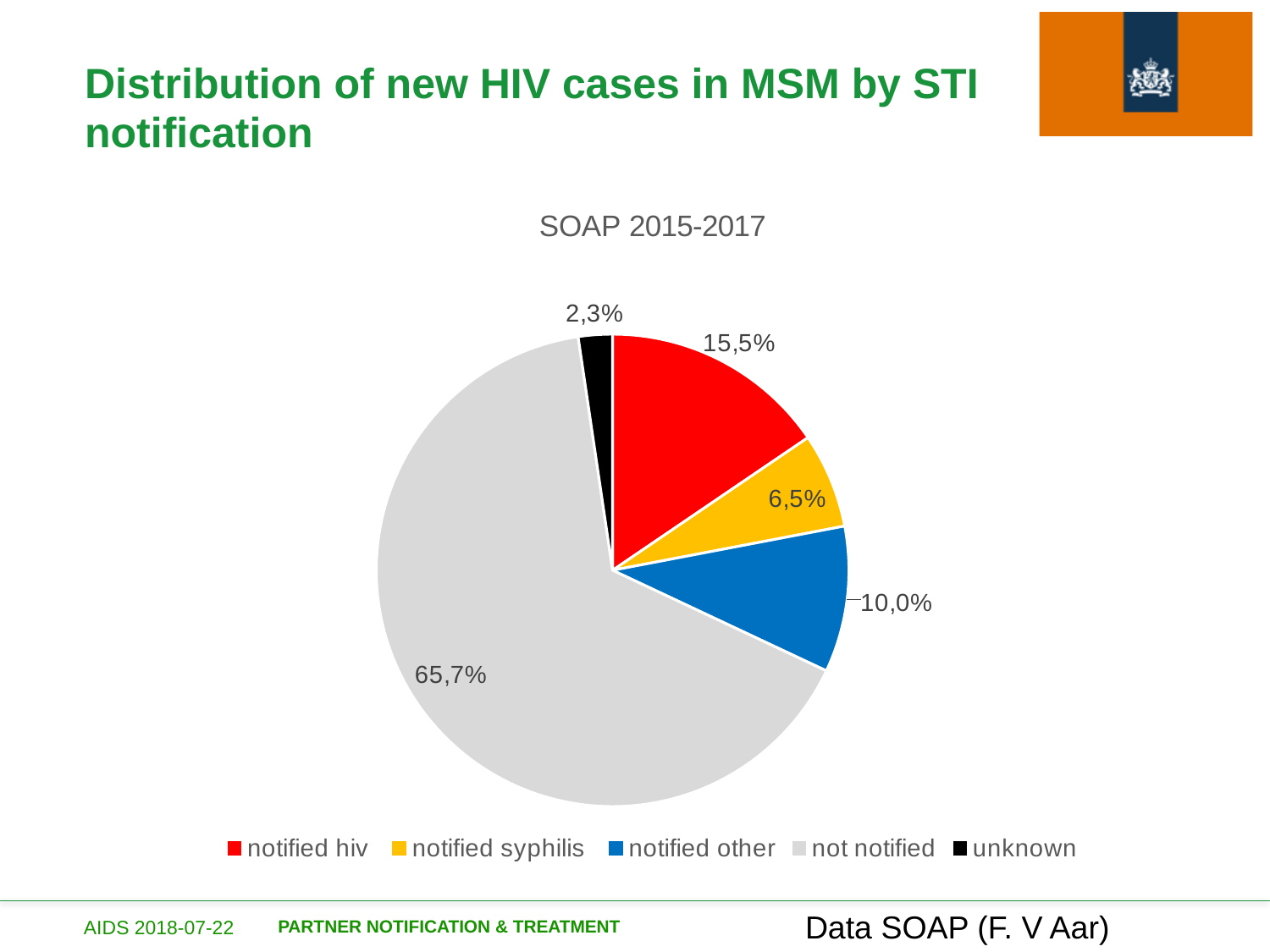
Which category has the smallest slice of the pie? unknown What share of new HIV cases is labelled 'not notified'? 65,7% What share of new HIV cases is labelled 'notified hiv'? 15,5% Which is larger, the share for 'notified hiv' or the share for 'notified other'? notified hiv What share of new HIV cases is labelled 'notified other'? 10,0% How many categories does the legend list? 5 What share of new HIV cases is labelled 'unknown'? 2,3% What is the title of the chart? SOAP 2015-2017 What share of new HIV cases is labelled 'notified syphilis'? 6,5% Which category has the largest slice of the pie? not notified What kind of chart is shown on the slide? pie chart What is the difference between the 'notified hiv' share and the 'notified syphilis' share? 9,0%